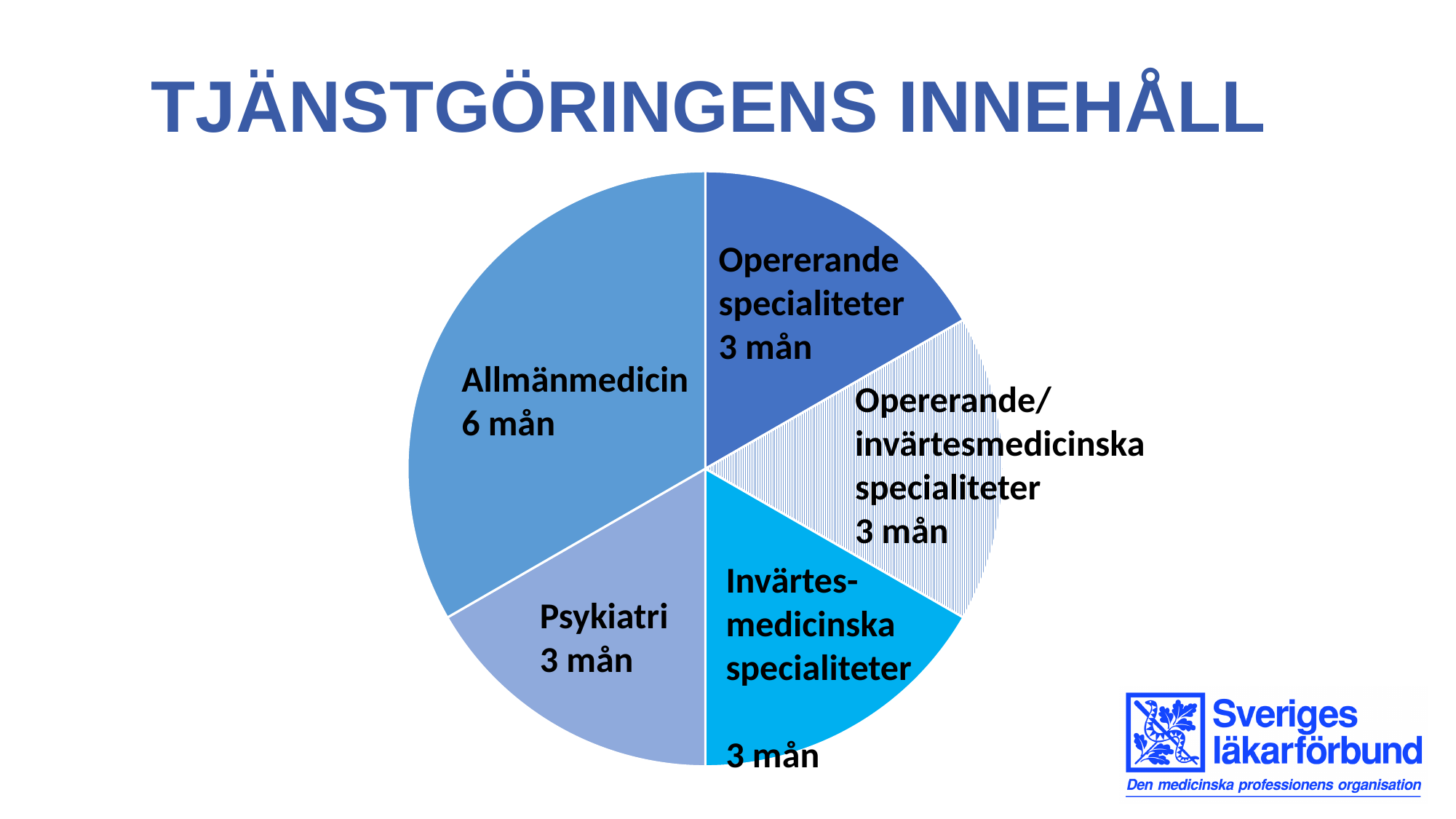
How many months are shown for Psykiatri? 3 mån What is the difference in months between Allmänmedicin and Psykiatri? 3 mån What share of the total does Allmänmedicin represent? one third What kind of chart is shown on the slide? pie chart How many slices does the pie chart have? 5 How many months are shown for Invärtesmedicinska specialiteter? 3 mån How many months are shown for Allmänmedicin? 6 mån Which category has the largest slice of the pie? Allmänmedicin What is the title of the slide? TJÄNSTGÖRINGENS INNEHÅLL What is the total number of months across all slices of the pie? 18 mån How many months are shown for Opererande specialiteter? 3 mån Which is larger, Allmänmedicin or Opererande specialiteter? Allmänmedicin